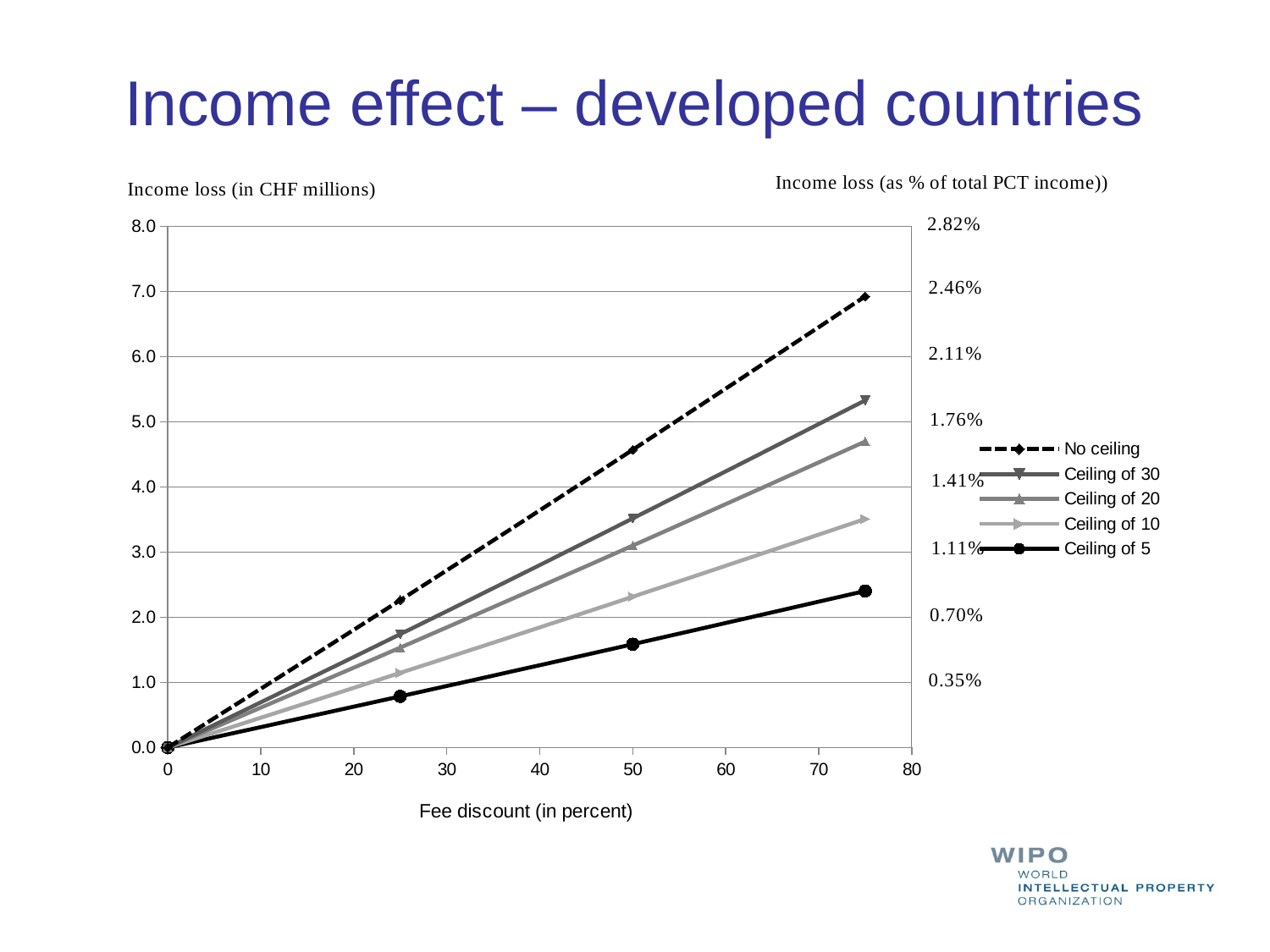
Is the income loss for the Ceiling of 5 series at a fee discount of 75 greater or less than 3.0 CHF millions? less What is the title of the x axis? Fee discount (in percent) Which series shows the lowest income loss at a fee discount of 75 percent? Ceiling of 5 How many series does the legend list? 5 Which series shows the highest income loss at a fee discount of 75 percent? No ceiling Is the income loss for the Ceiling of 30 series at a fee discount of 75 greater or less than 5.0 CHF millions? greater At a fee discount of 50 percent, which series has the larger income loss: Ceiling of 20 or Ceiling of 10? Ceiling of 20 What is the label of the left vertical axis? Income loss (in CHF millions) Is the income loss for the No ceiling series at a fee discount of 75 greater or less than 6.0 CHF millions? greater What kind of chart is shown on the slide? Line chart Do the income loss values rise or fall as the fee discount increases? Rise